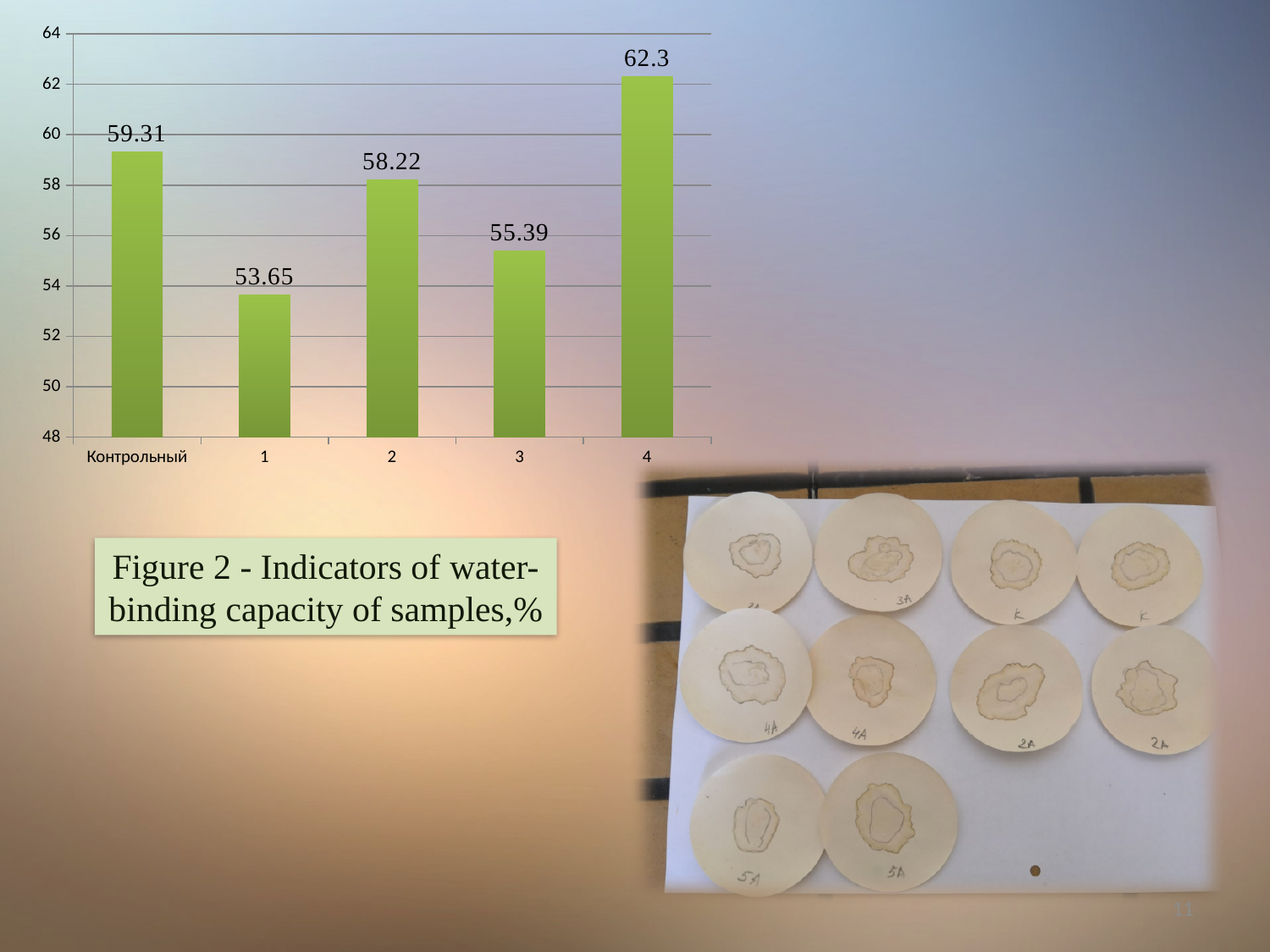
Which is larger, the value for category 2 or the value for category 3? 2 How many categories are shown on the x axis? 5 According to the caption, what does Figure 2 show? Indicators of water-binding capacity of samples,% What is the difference between the values for Контрольный and category 2? 1.09 What is the value for category 3? 55.39 What is the value for category 4? 62.3 Which category has the lowest value? 1 What is the value for the Контрольный category? 59.31 What is the value for category 1? 53.65 What kind of chart is shown on the slide? bar chart What is the difference between the values for category 4 and category 1? 8.65 Which category has the highest value? 4